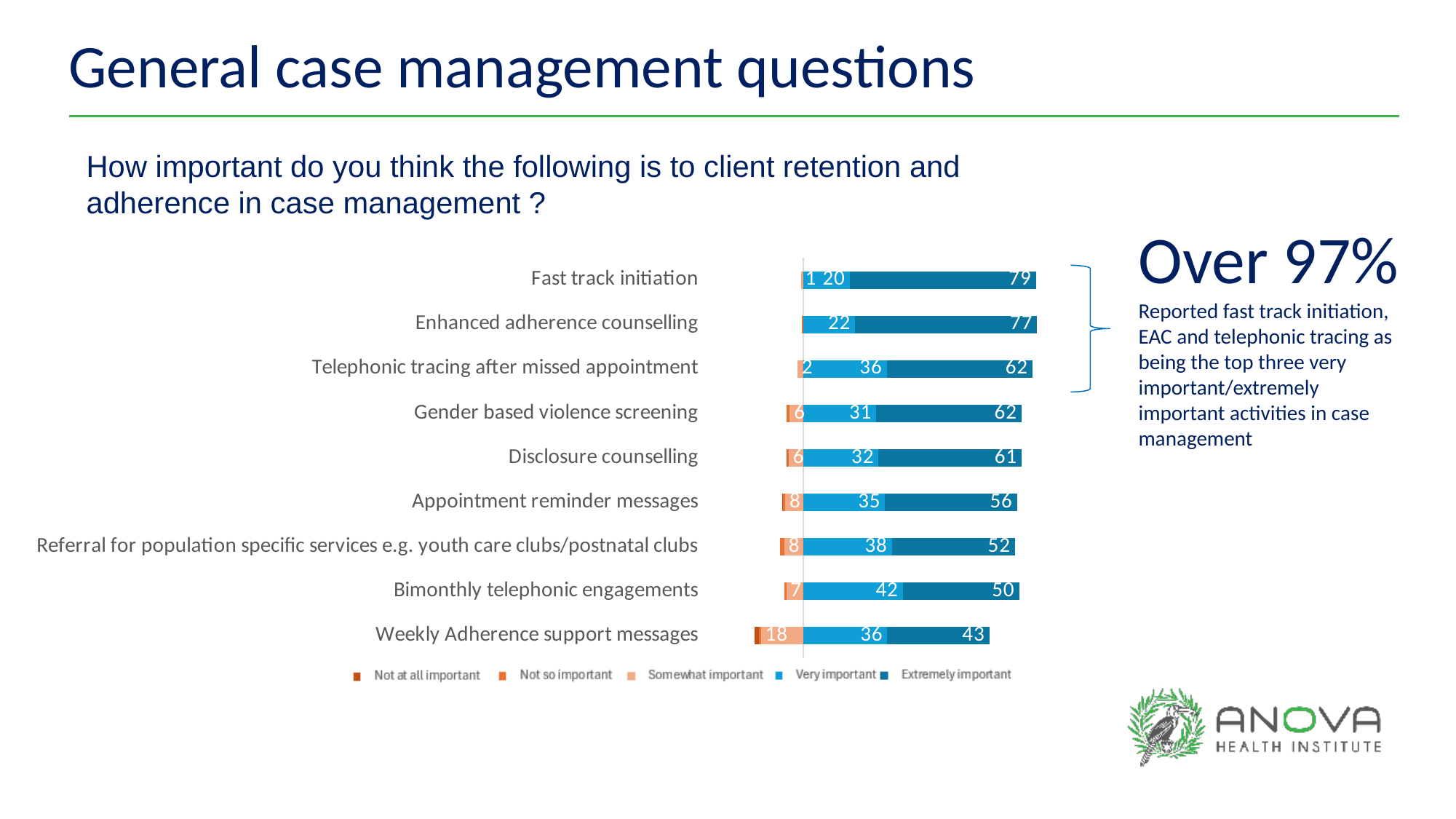
What is the 'Extremely important' value for Fast track initiation? 79 What kind of chart is shown on the slide? Stacked bar chart What is the 'Very important' value for Telephonic tracing after missed appointment? 36 Which has a larger 'Very important' value: Appointment reminder messages or Referral for population specific services e.g. youth care clubs/postnatal clubs? Referral for population specific services e.g. youth care clubs/postnatal clubs What is the difference between the 'Extremely important' values for Fast track initiation and Enhanced adherence counselling? 2 Which legend entry is shown in the darkest blue colour? Extremely important Which activity has the lowest 'Extremely important' value? Weekly Adherence support messages Which activity has the highest 'Very important' value? Bimonthly telephonic engagements What is the 'Somewhat important' value for Weekly Adherence support messages? 18 How many series does the chart legend list? 5 How many activities (categories) are plotted in the chart? 9 Which activity has the highest 'Extremely important' value? Fast track initiation